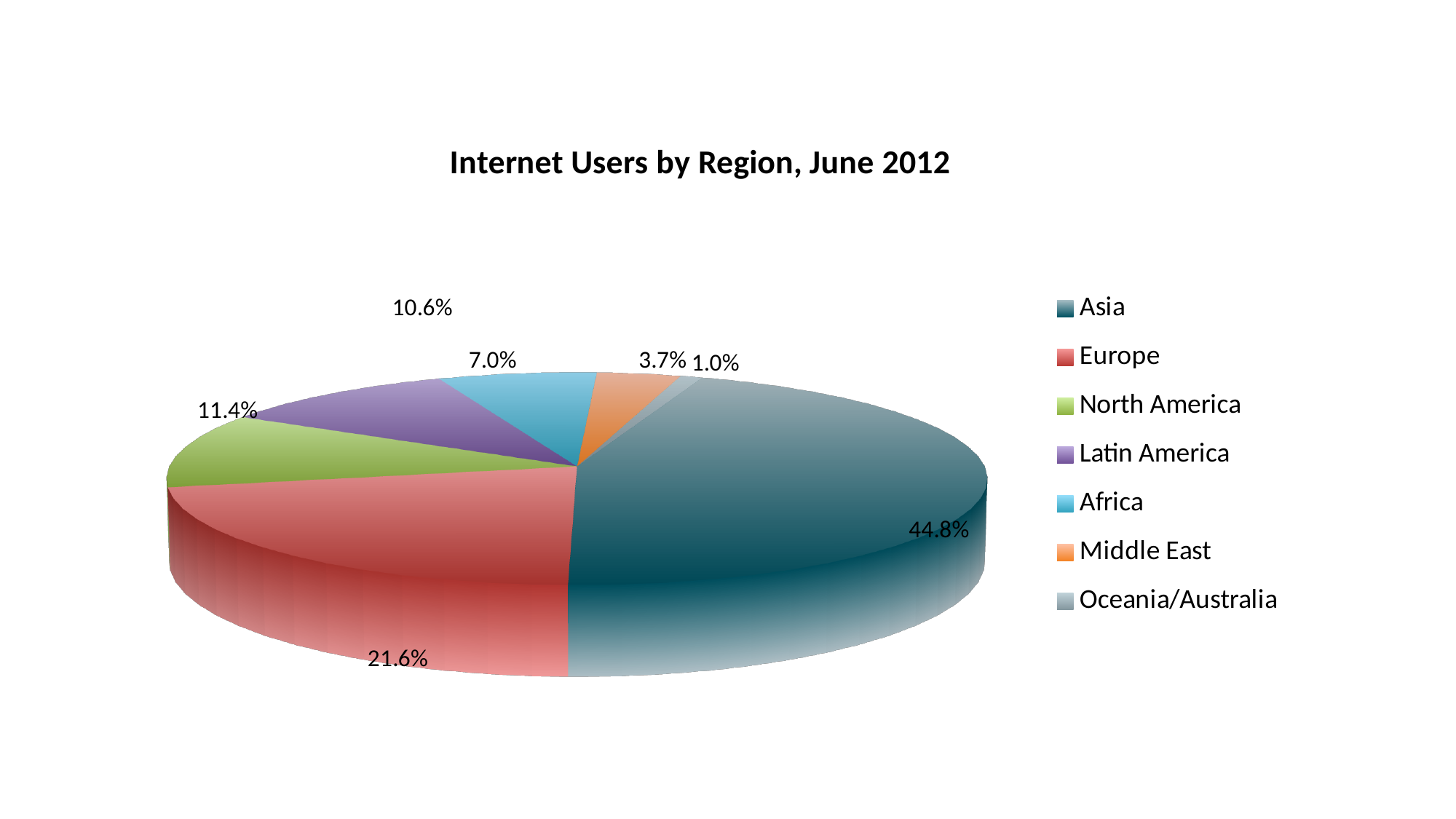
What type of chart is shown on the slide? Pie chart What share of internet users does Asia account for? 44.8% What is the value for Africa? 7.0% Which region has the smallest share of internet users? Oceania/Australia What is the value for North America? 11.4% What percentage is shown for Europe? 21.6% What percentage is shown for the Middle East? 3.7% How many regions are shown in the pie chart? 7 Which has a larger share, North America or Latin America? North America What is the difference in percentage points between Asia and Europe? 23.2 Which region has the largest share of internet users? Asia What percentage is shown for Latin America? 10.6%